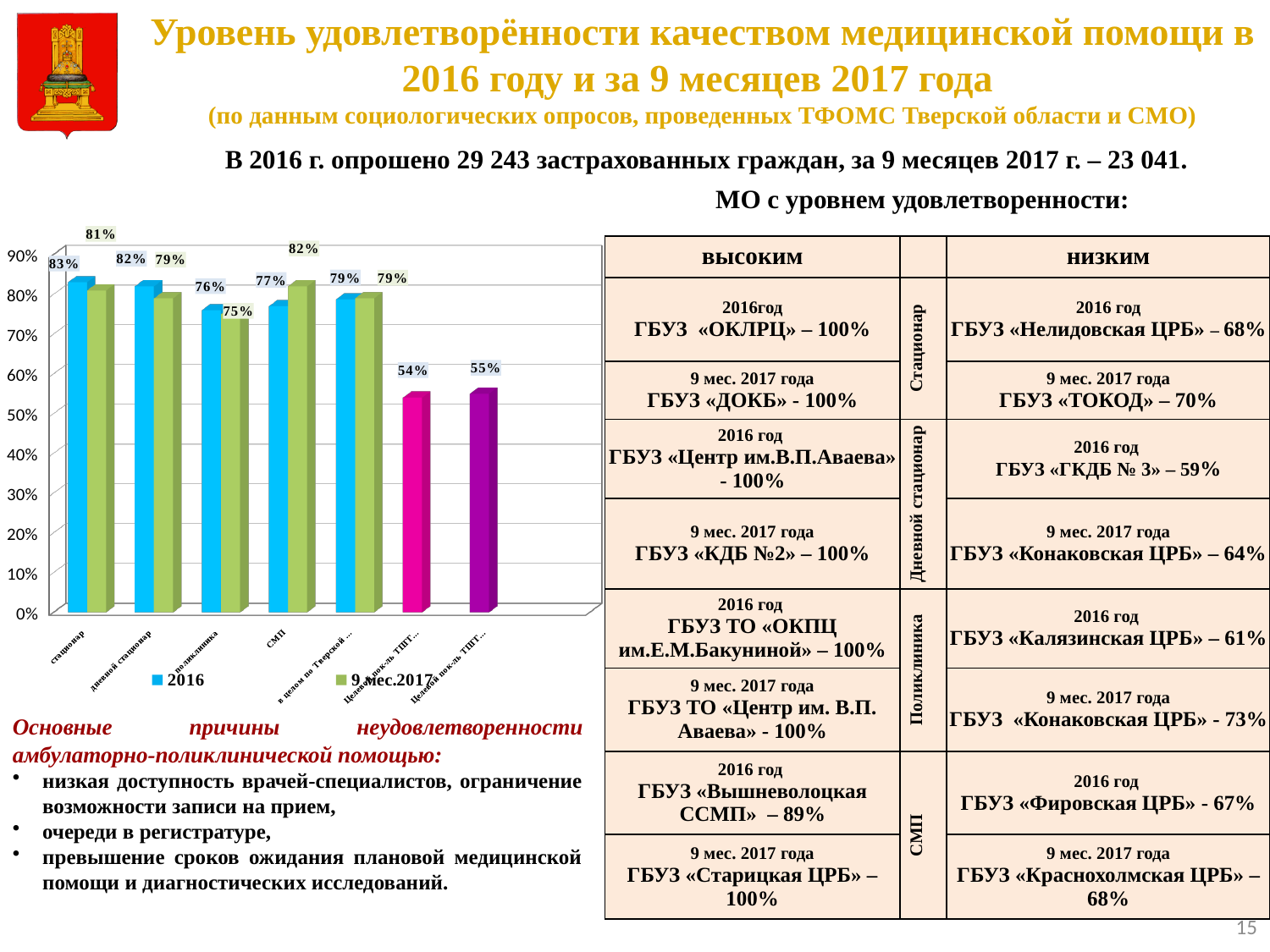
What kind of chart is shown on the slide? bar chart What is the 9 мес.2017 value for дневной стационар? 79% How many series does the chart legend list? 2 For СМП, which series has the larger value: 2016 or 9 мес.2017? 9 мес.2017 What is the difference between the 2016 and 9 мес.2017 values for стационар? 2% Among стационар, дневной стационар, поликлиника and СМП, which has the lowest 2016 value? поликлиника Among стационар, дневной стационар, поликлиника and СМП, which has the highest 2016 value? стационар What is the difference between the 9 мес.2017 and 2016 values for СМП? 5% Is the 9 мес.2017 value for поликлиника greater or less than 70%? greater What is the 2016 value for поликлиника? 76% What is the 9 мес.2017 value for СМП? 82% What is the 2016 value for стационар? 83%